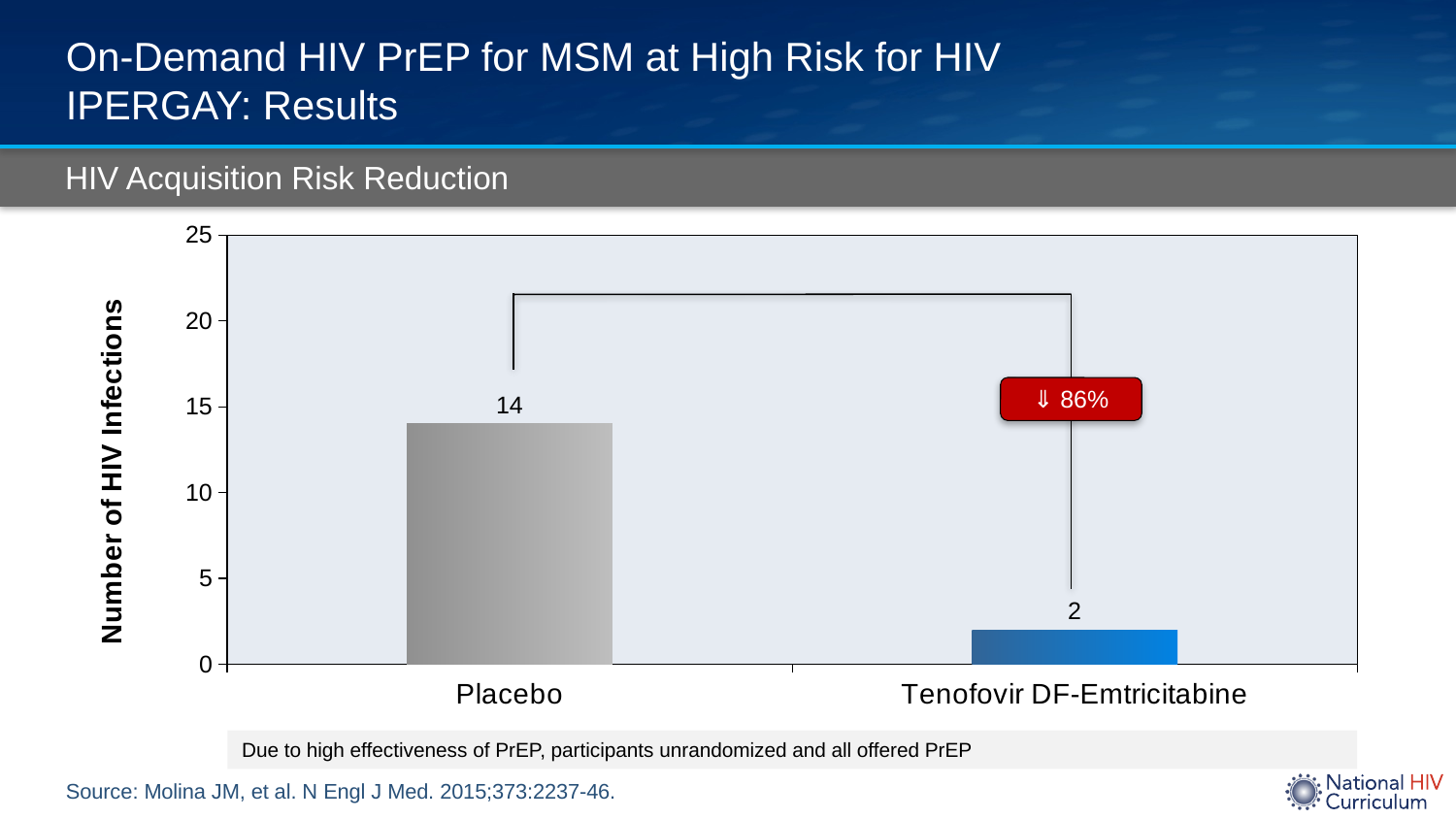
Is the number of HIV infections for Tenofovir DF-Emtricitabine greater or less than 5? less Is the number of HIV infections for Placebo greater or less than 10? greater What percentage risk reduction is annotated on the chart? 86% What kind of chart is shown on the slide? Bar chart Which group had the highest number of HIV infections? Placebo Which group had more HIV infections, Placebo or Tenofovir DF-Emtricitabine? Placebo Which group had the lowest number of HIV infections? Tenofovir DF-Emtricitabine What is the number of HIV infections for the Tenofovir DF-Emtricitabine group? 2 What is the difference in the number of HIV infections between the Placebo and Tenofovir DF-Emtricitabine groups? 12 What is the number of HIV infections for the Placebo group? 14 How many groups are shown on the chart? 2 What is the label of the y-axis? Number of HIV Infections